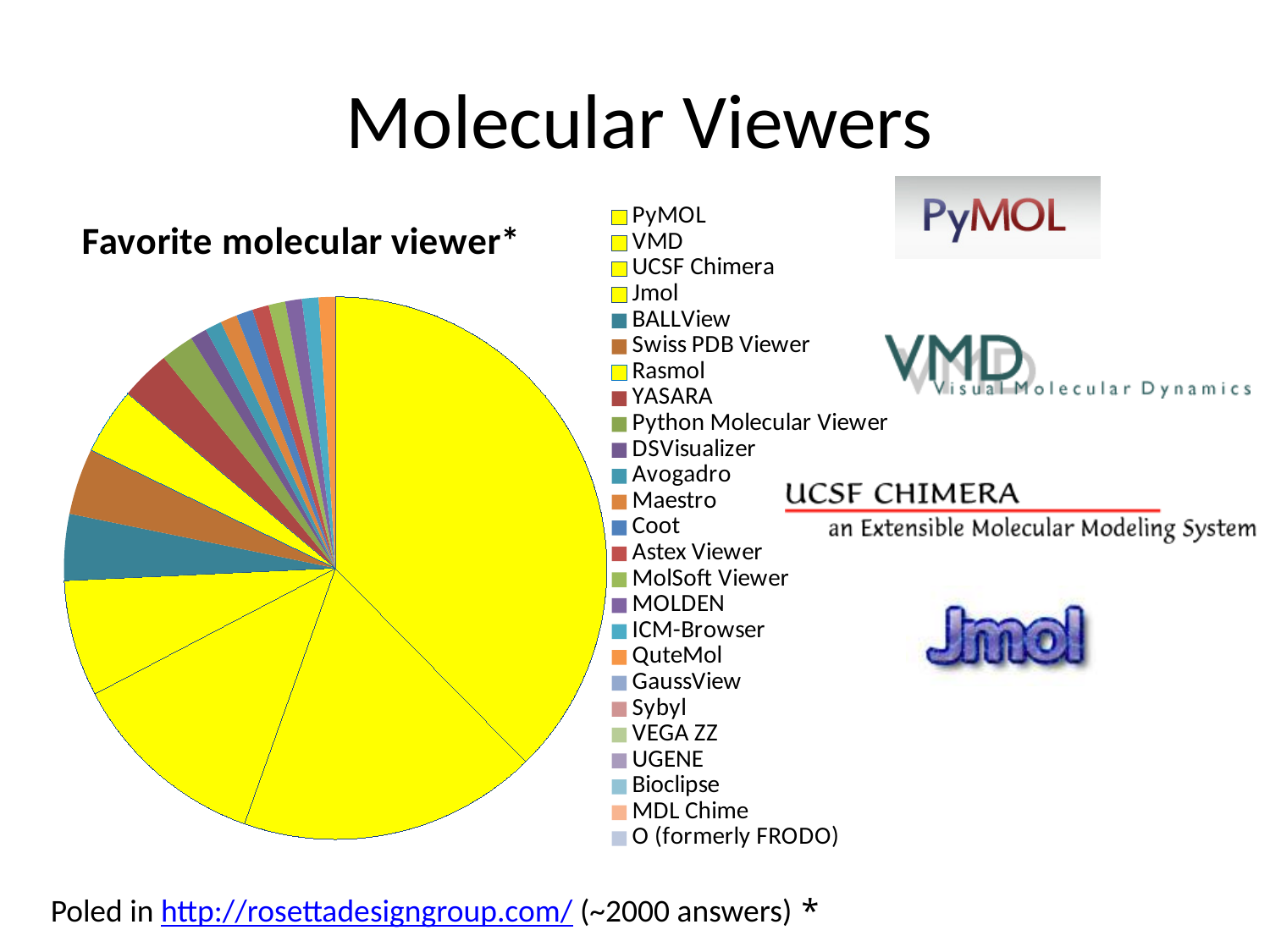
Which molecular viewer has the largest slice of the pie? PyMOL Which slice is larger, PyMOL or VMD? PyMOL Which slice is larger, PyMOL or Jmol? PyMOL Which slice is larger, UCSF Chimera or Rasmol? UCSF Chimera How many entries does the chart's legend list? 25 What is the title of the chart? Favorite molecular viewer* What is the last entry listed in the chart's legend? O (formerly FRODO) What kind of chart is shown on the slide? pie chart